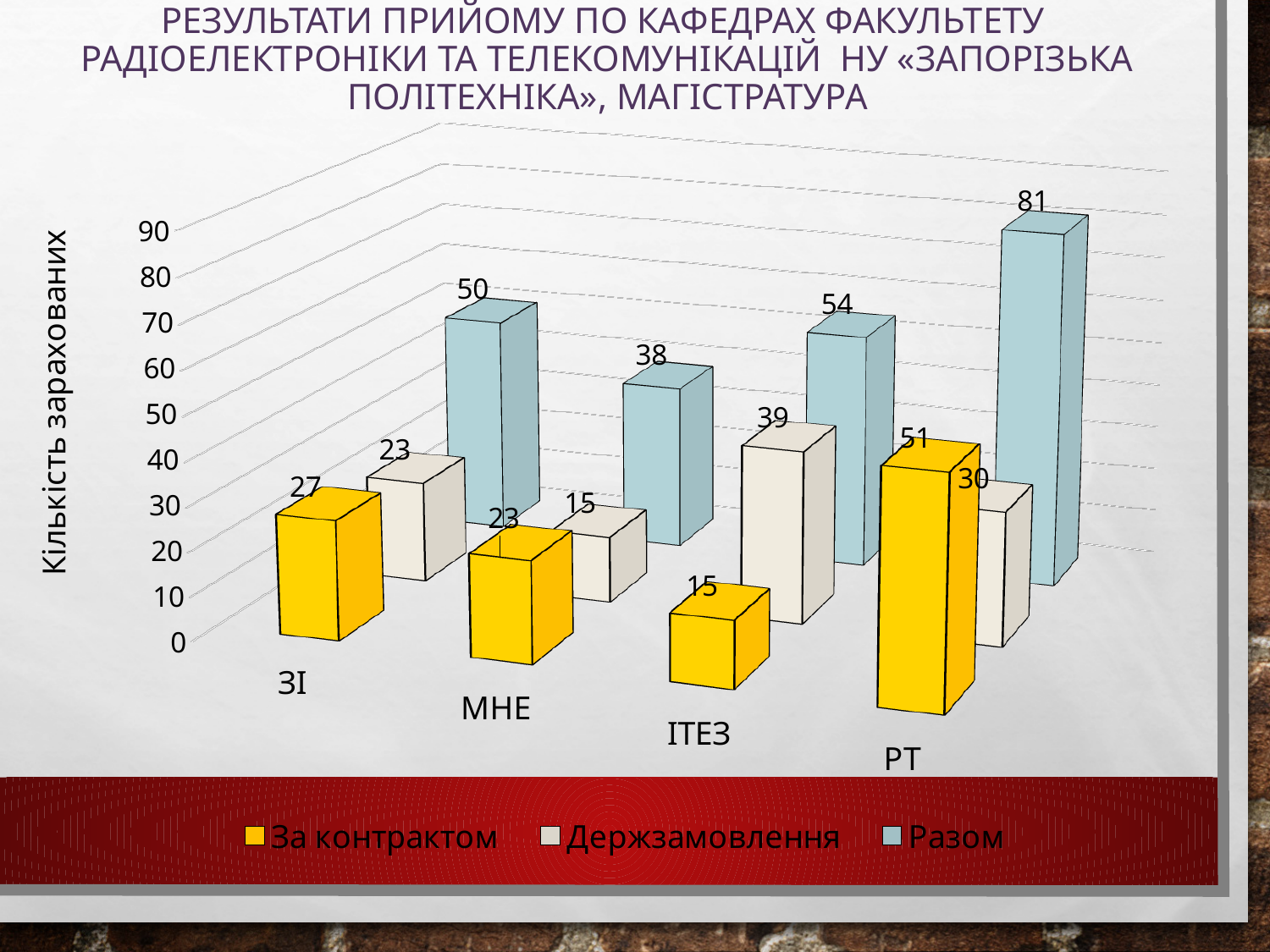
Which category has the highest Разом value? РТ What is the difference between the Разом values for РТ and ЗІ? 31 Which category has the lowest За контрактом value? ІТЕЗ What is the value of За контрактом for ЗІ? 27 What is the value of Разом for МНЕ? 38 Which is larger for ІТЕЗ: За контрактом or Держзамовлення? Держзамовлення How many categories are shown on the x axis? 4 What is the value of Держзамовлення for ІТЕЗ? 39 What is the value of Разом for РТ? 81 What kind of chart is shown on the slide? Bar chart What is the label of the vertical axis? Кількість зарахованих How many series does the legend list? 3